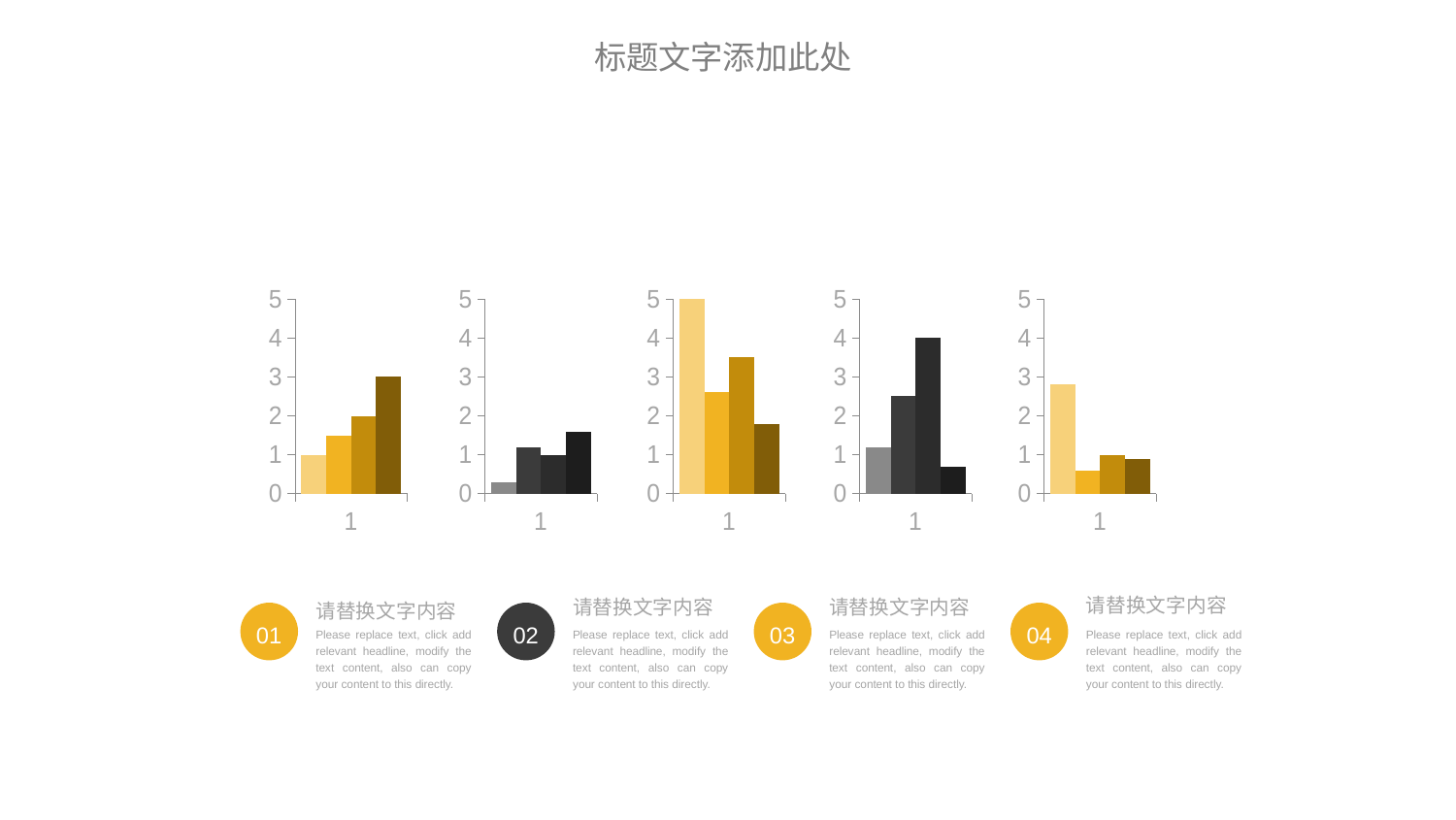
In the leftmost chart, how many bars are plotted? 4 What is the highest value shown on the vertical axis of each chart? 5 What kind of charts are shown on the slide? Bar charts In the fourth chart, is the value of the rightmost (black) bar greater or less than 1? less In the second chart, which bar is the tallest? The rightmost (black) bar In the leftmost chart, do the bar heights rise or fall from left to right? Rise In the middle (third) chart, which bar is the shortest? The rightmost (dark brown) bar In the fourth chart, what is the value of the tallest (third, dark grey) bar? 4 In the rightmost chart, is the value of the leftmost (light yellow) bar greater or less than 2? greater In the middle (third) chart, what is the value of the tallest (leftmost, light yellow) bar? 5 In the leftmost chart, what is the value of the tallest (rightmost, dark brown) bar? 3 How many charts are on the slide? 5